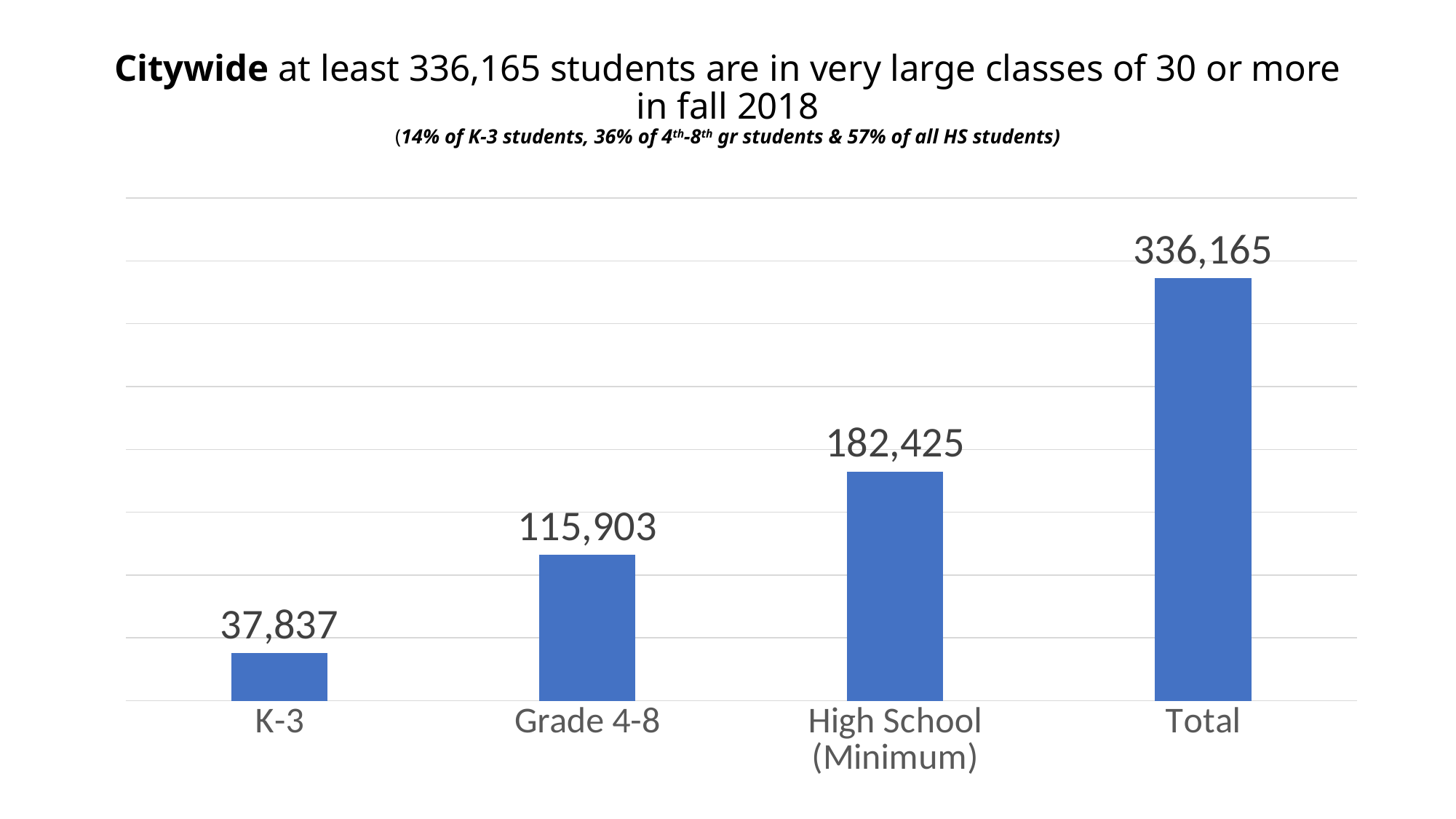
What is the value for Total? 336,165 What is the difference between the High School (Minimum) value and the Grade 4-8 value? 66,522 How many categories are shown on the x axis? 4 Do the values rise or fall from left to right along the x axis? Rise What is the value for Grade 4-8? 115,903 What is the value for High School (Minimum)? 182,425 Which is larger, the value for Grade 4-8 or the value for High School (Minimum)? High School (Minimum) Which category has the highest value? Total What is the value for K-3? 37,837 Which category has the lowest value? K-3 What is the difference between the Grade 4-8 value and the K-3 value? 78,066 What kind of chart is shown on the slide? Bar chart